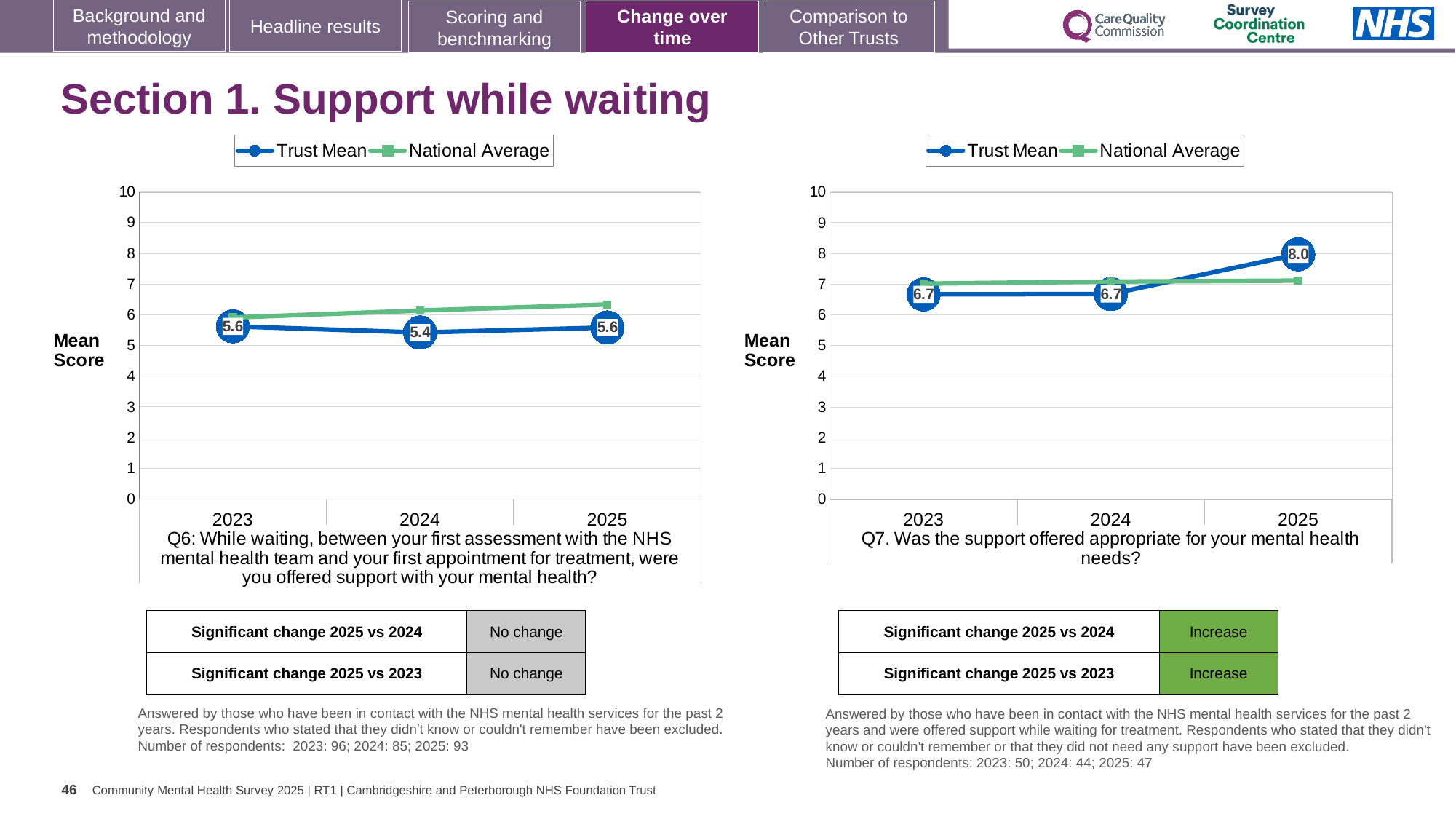
In the right chart (Q7), what is the Trust Mean for 2023? 6.7 What kind of chart is the left chart (Q6)? Line chart In the right chart (Q7), what is the Trust Mean for 2025? 8.0 In the right chart (Q7), which year has the highest Trust Mean? 2025 How many series does the legend of the right chart (Q7) list? 2 In the left chart (Q6), what is the Trust Mean for 2024? 5.4 In the right chart (Q7), is the National Average value for 2025 greater or less than 8? less In the left chart (Q6), which year has the lowest Trust Mean? 2024 In the right chart (Q7), what is the difference between the Trust Mean for 2025 and the Trust Mean for 2024? 1.3 In the left chart (Q6), which is higher in 2025, the Trust Mean or the National Average? National Average In the right chart (Q7), does the Trust Mean rise or fall from 2024 to 2025? Rise In the left chart (Q6), what is the Trust Mean for 2025? 5.6